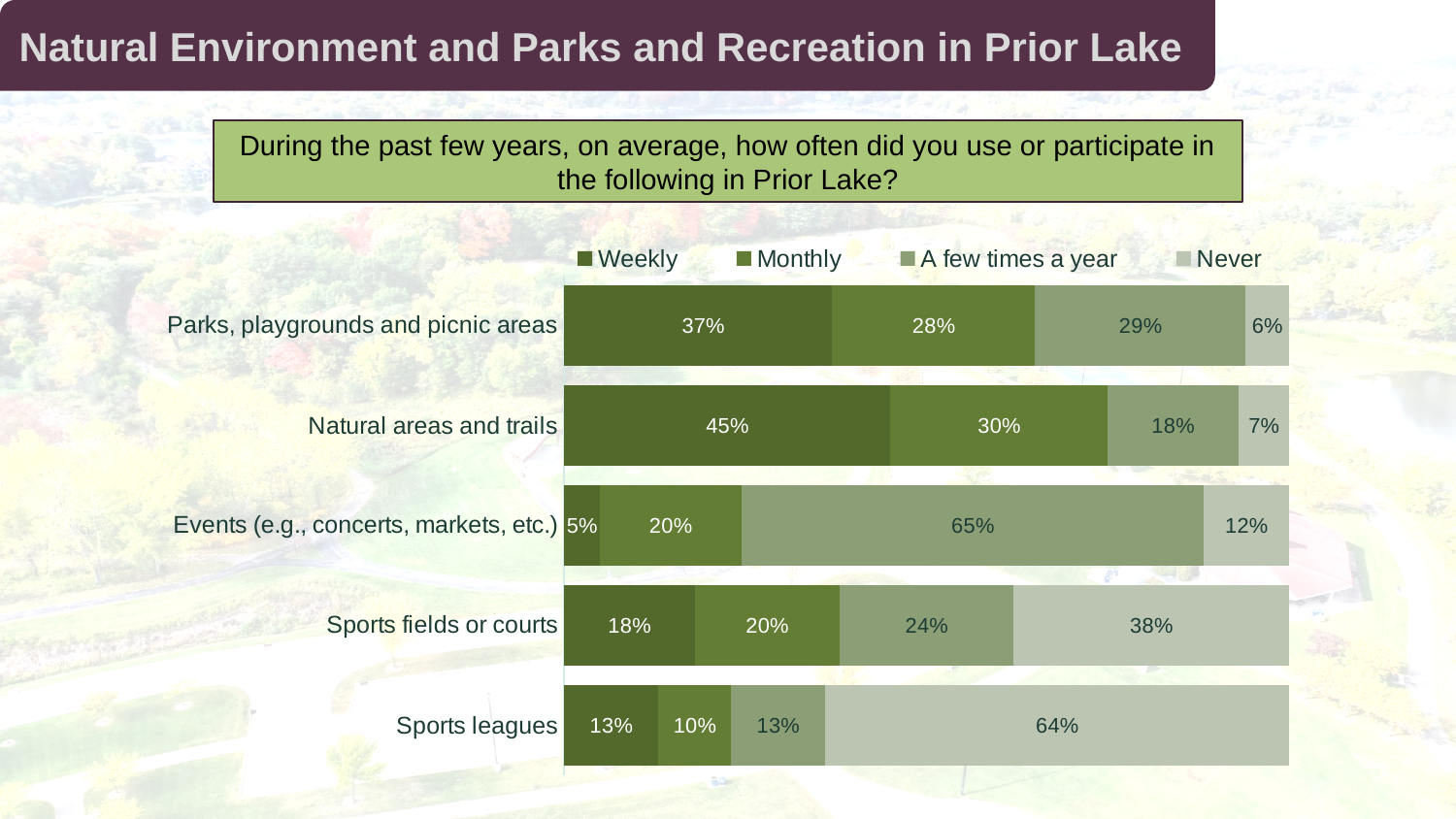
What is the combined percentage of respondents who use natural areas and trails weekly or monthly? 75% How many series does the legend list? 4 Which category has the highest weekly usage? Natural areas and trails What kind of chart is shown on the slide? Stacked bar chart What percentage of respondents use parks, playgrounds and picnic areas weekly? 37% What percentage of respondents attend events a few times a year? 65% What is the last series listed in the legend? Never Which is larger: the monthly percentage for natural areas and trails or the monthly percentage for sports fields or courts? Natural areas and trails Which category has the lowest weekly usage? Events (e.g., concerts, markets, etc.) How many categories are shown in the chart? 5 What percentage of respondents never participate in sports leagues? 64% What is the difference between the 'Never' percentages for sports fields or courts and natural areas and trails? 31%